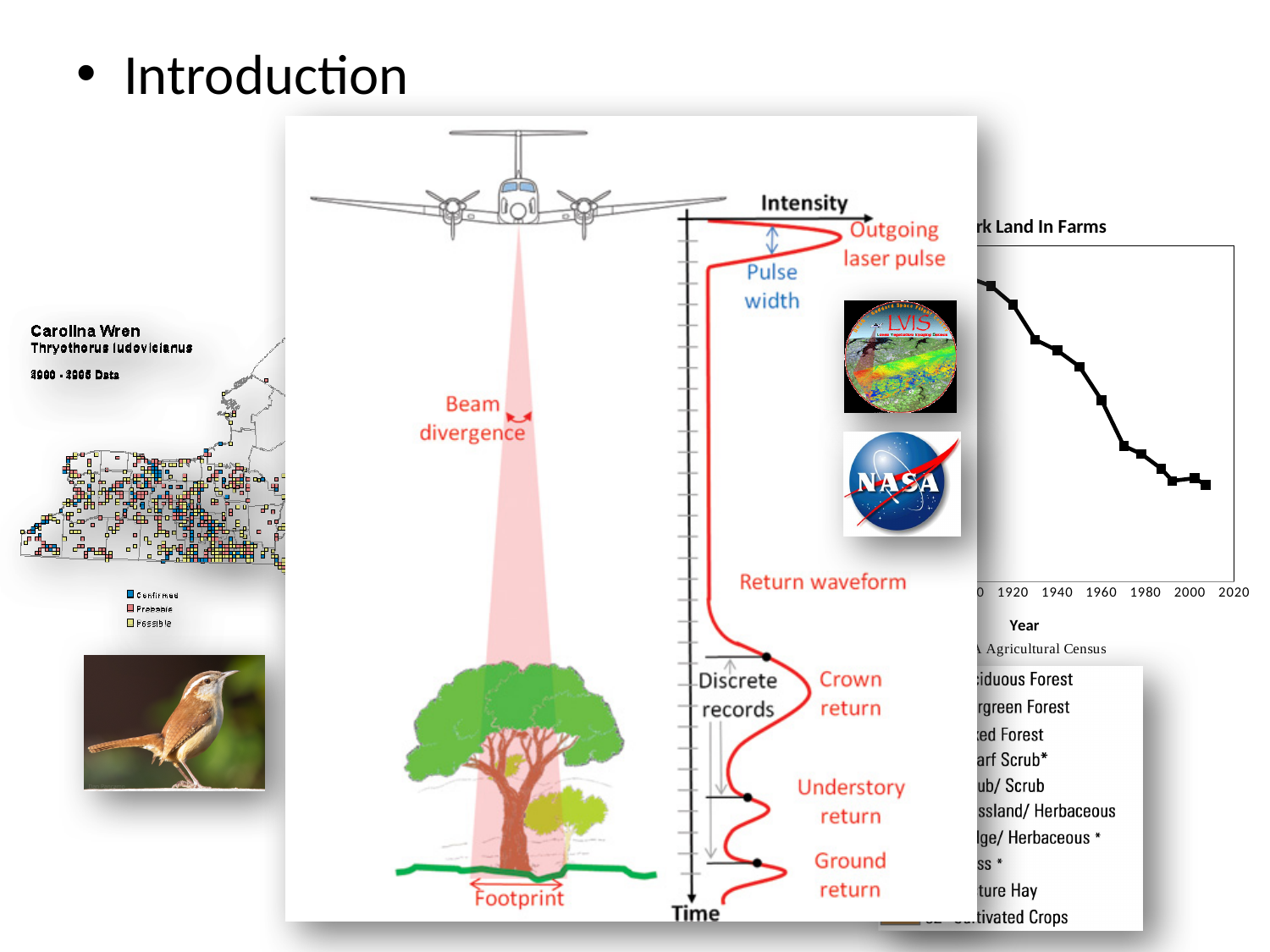
What kind of chart is the 'Land In Farms' chart on the right side of the slide? line chart In the 'Land In Farms' chart, do the values rise or fall as the year increases? fall In the 'Land In Farms' chart, which is larger: the value around 1940 or the value around 2000? 1940 In the 'Land In Farms' chart, which is larger: the value around 1960 or the value around 1980? 1960 What is the last year tick label shown on the x-axis of the 'Land In Farms' chart? 2020 What is the x-axis title of the 'Land In Farms' chart? Year